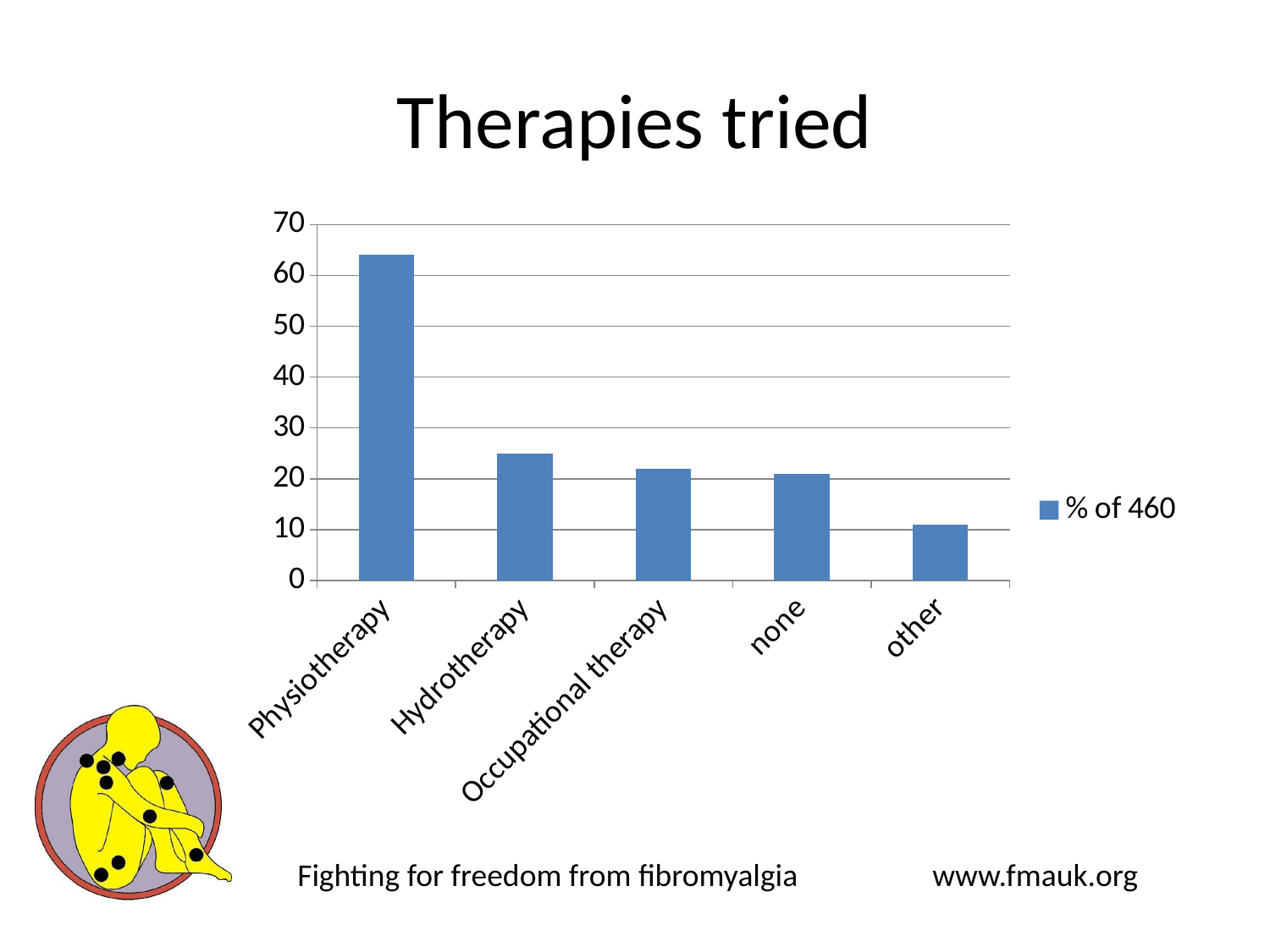
Which category has the lowest value? other What is the title of the chart? Therapies tried How many therapy categories are shown on the x axis? 5 Is the value for Occupational therapy greater or less than 30? less Which is larger, the value for Physiotherapy or the value for Hydrotherapy? Physiotherapy Is the value for other greater or less than 20? less Is the value for Hydrotherapy greater or less than 30? less Which category has the highest value? Physiotherapy What kind of chart is shown on the slide? bar chart How many series does the legend list? 1 What is the legend entry for the series? % of 460